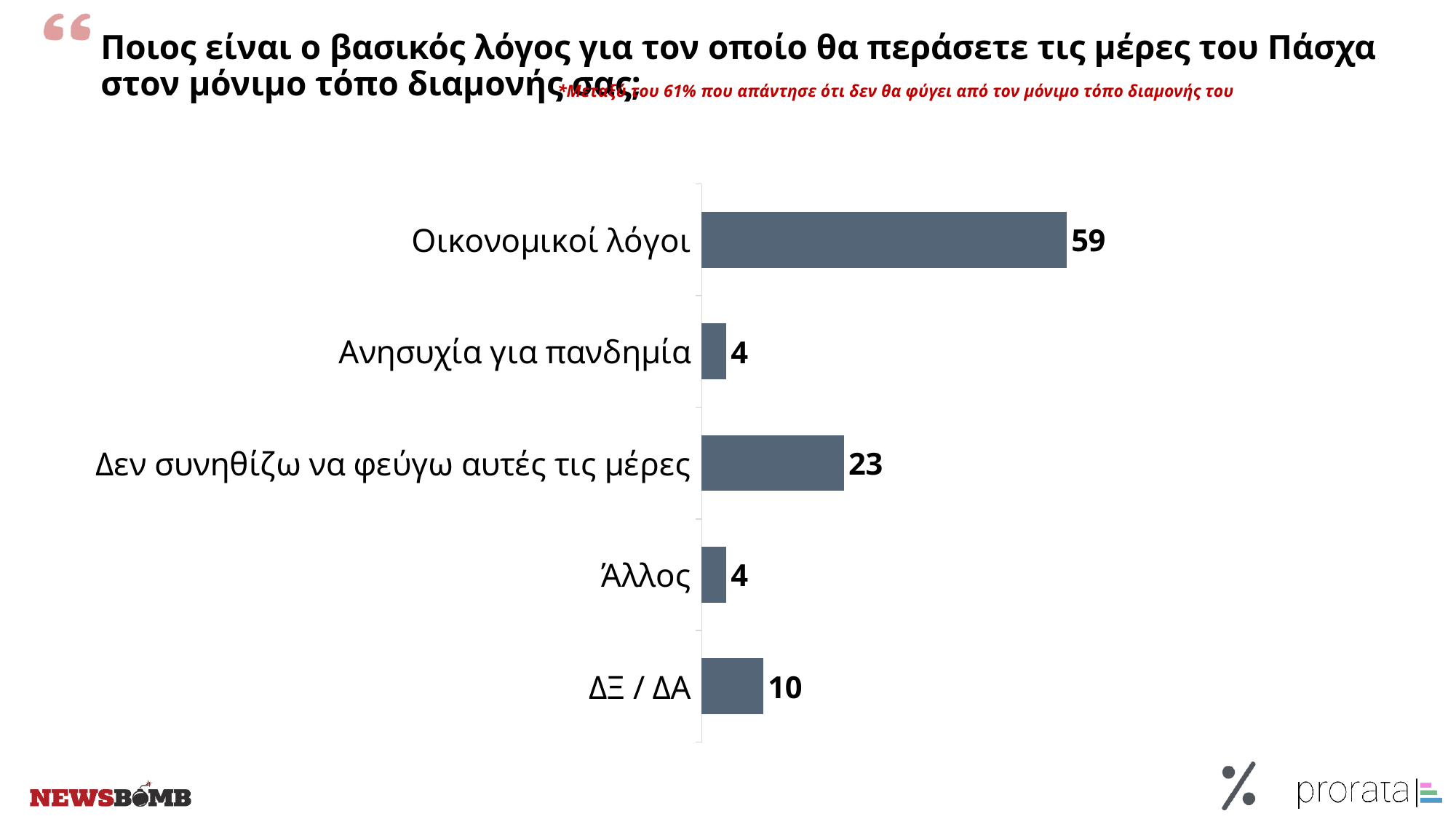
What is the value for ΔΞ / ΔΑ? 10 Which is larger, the value for Δεν συνηθίζω να φεύγω αυτές τις μέρες or the value for ΔΞ / ΔΑ? Δεν συνηθίζω να φεύγω αυτές τις μέρες How many categories are shown in the chart? 5 What is the value for Δεν συνηθίζω να φεύγω αυτές τις μέρες? 23 What kind of chart is shown on the slide? Bar chart Which two categories share the same value of 4? Ανησυχία για πανδημία and Άλλος What is the difference between the values for ΔΞ / ΔΑ and Άλλος? 6 What is the value for Οικονομικοί λόγοι? 59 What is the value for Ανησυχία για πανδημία? 4 What colour are the bars in the chart? Dark grey-blue What is the difference between the values for Οικονομικοί λόγοι and Δεν συνηθίζω να φεύγω αυτές τις μέρες? 36 Which category has the highest value? Οικονομικοί λόγοι